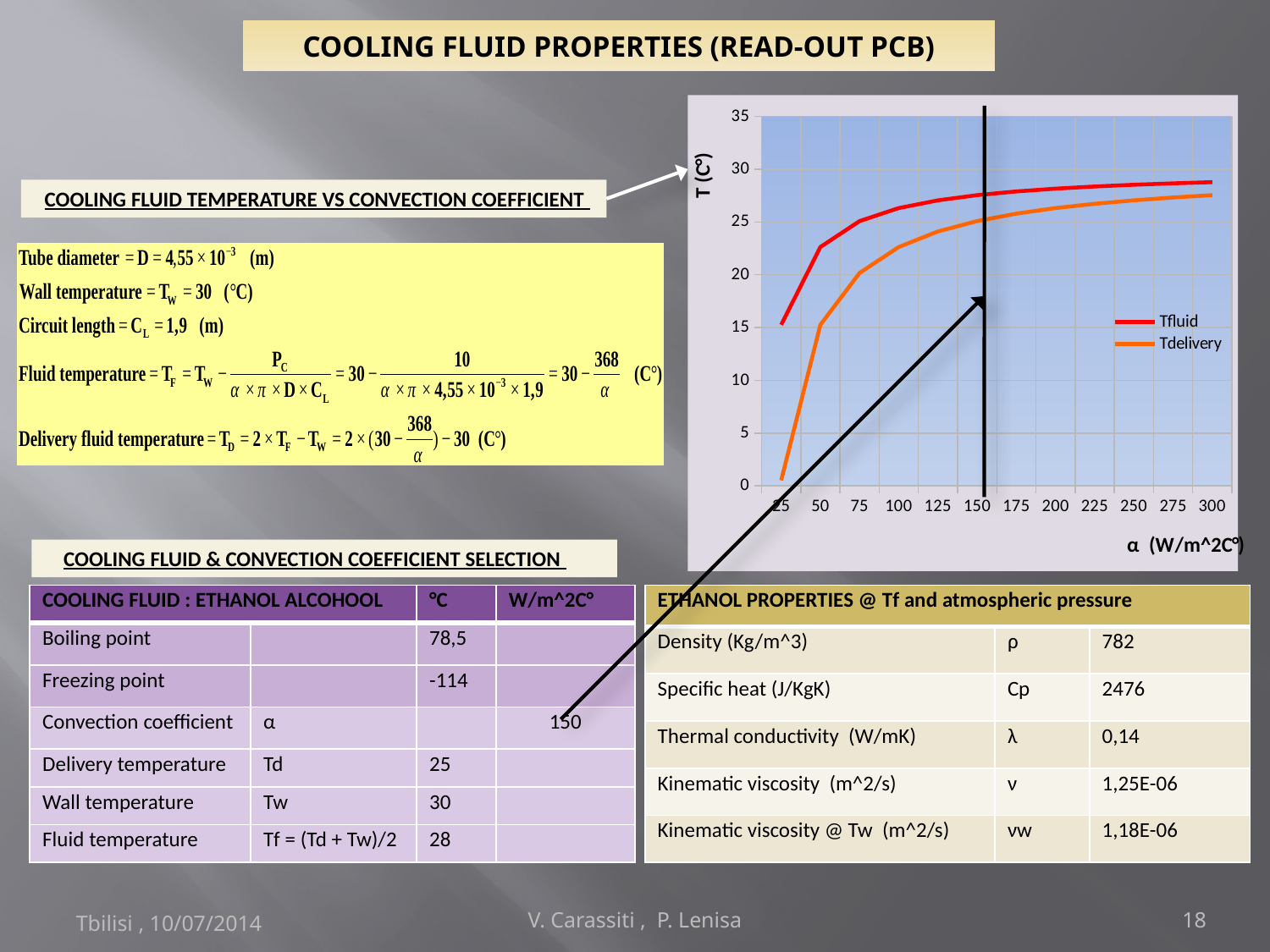
Is the Tdelivery value at α = 300 greater or less than 25? greater What are the two series named in the chart legend? Tfluid and Tdelivery Which series has the higher value at α = 50, Tfluid or Tdelivery? Tfluid Is the Tfluid value at α = 25 greater or less than 20? less Do the Tfluid values rise or fall as α increases along the x axis? rise What kind of chart is shown on the slide? line chart Do the Tdelivery values rise or fall as α increases along the x axis? rise What is the label of the chart's x axis? α (W/m^2C°) Is the Tfluid value at α = 300 greater or less than 30? less How many tick labels are shown on the chart's x axis? 12 How many series does the chart legend list? 2